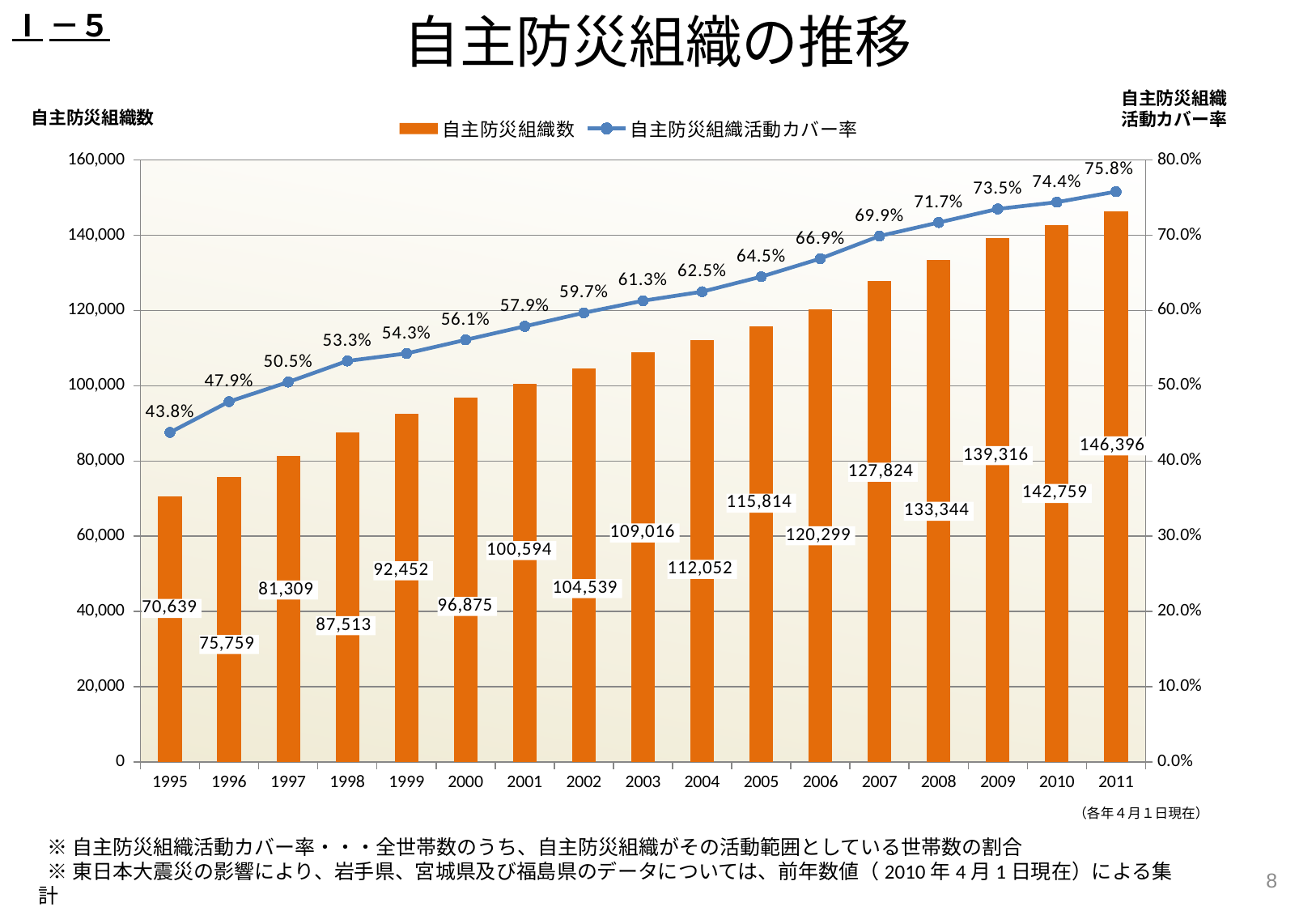
What is the number of 自主防災組織 (bar series) in 2003? 109,016 What is the number of 自主防災組織 in 1995? 70,639 Is the number of 自主防災組織 in 2001 greater or less than 100,000? greater What is the 自主防災組織活動カバー率 (line series) in 2006? 66.9% Does the 自主防災組織活動カバー率 rise or fall from 1995 to 2011? rise What is the difference in the number of 自主防災組織 between 2011 and 2010? 3,637 Which year has the highest number of 自主防災組織? 2011 How many series does the legend list? 2 What kind of chart is used for the 自主防災組織数 series? bar chart Which year has the lowest 自主防災組織活動カバー率? 1995 Which is larger: the number of 自主防災組織 in 2008 or in 2005? 2008 How many years are shown on the x axis? 17